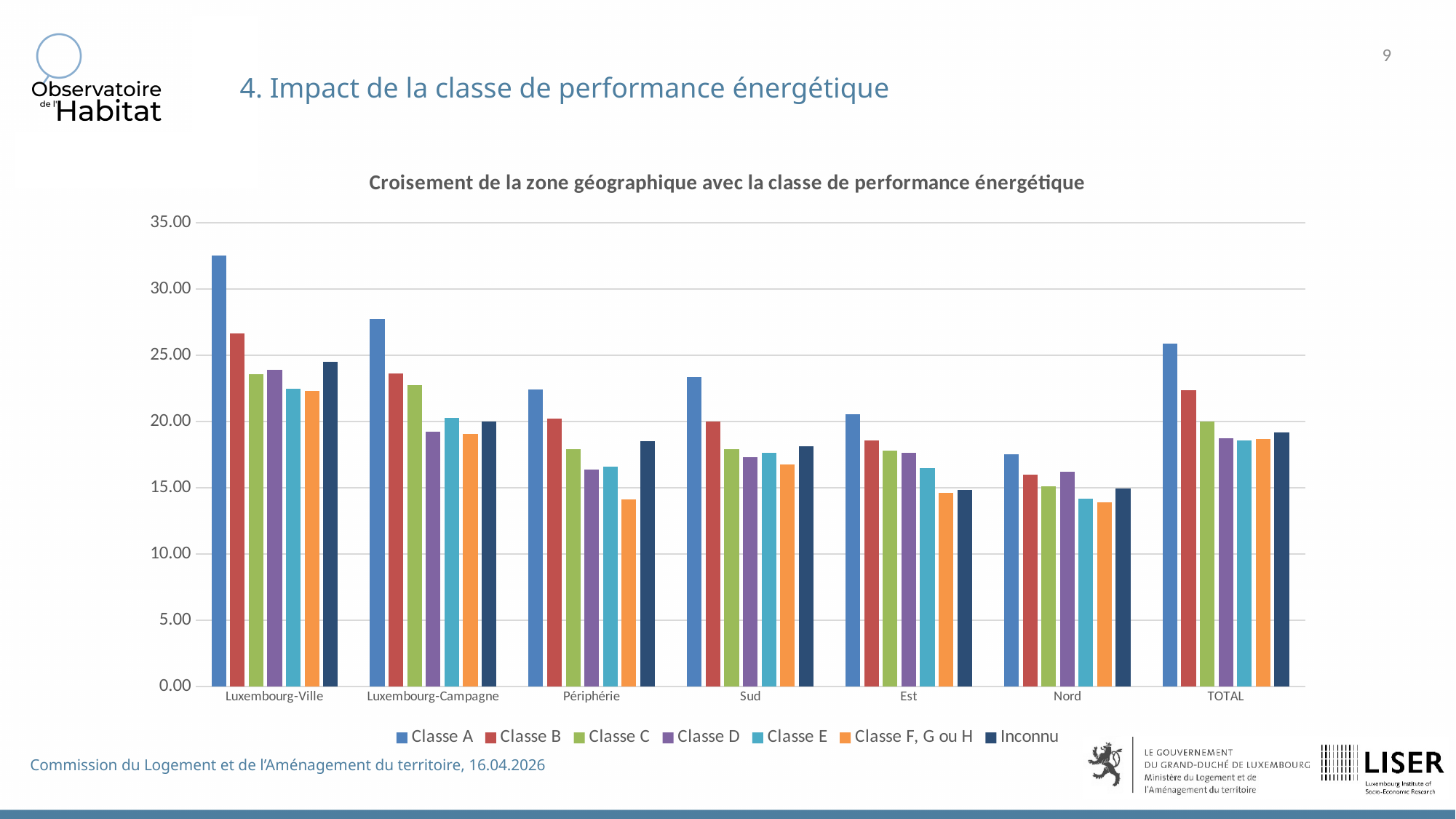
Which is larger: Classe A in Luxembourg-Campagne or Classe A in Sud? Luxembourg-Campagne Is the value for Classe A in TOTAL greater or less than 25.00? greater What kind of chart is shown on the slide? bar chart How many categories are shown on the x axis? 7 What is the title of the chart? Croisement de la zone géographique avec la classe de performance énergétique Is the value for Classe A in Luxembourg-Ville greater or less than 30.00? greater Which category has the highest value for Classe A? Luxembourg-Ville How many series does the legend list? 7 In Sud, which is larger: Classe A or Classe B? Classe A Which category has the lowest value for Classe A? Nord What is the last entry in the chart legend? Inconnu Is the value for Classe F, G ou H in Périphérie greater or less than 15.00? less